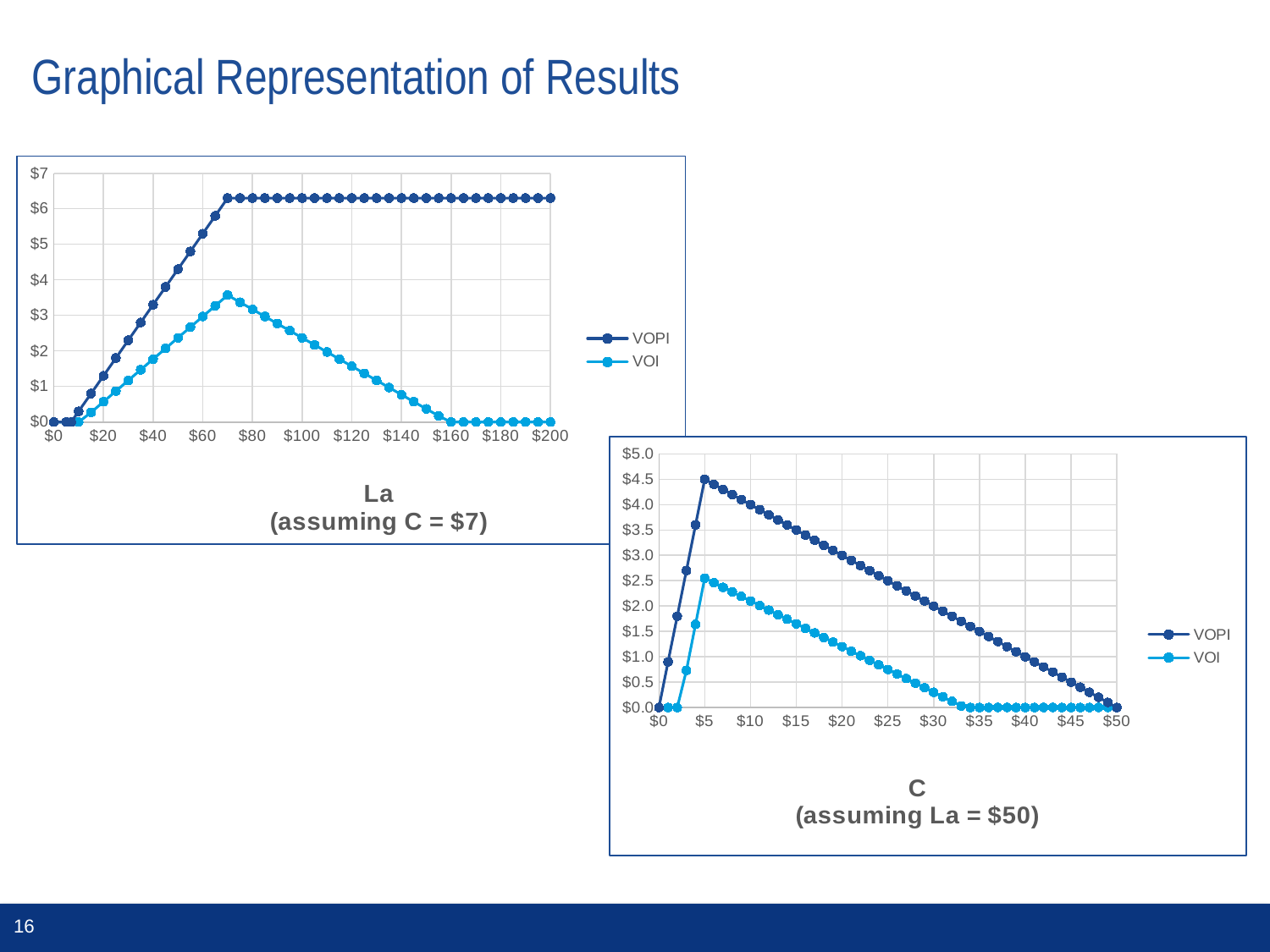
In the chart titled "C (assuming La = $50)", is the value of VOPI at $25 greater or less than $3.5? less What kind of chart is the chart titled "La (assuming C = $7)"? line chart In the chart titled "La (assuming C = $7)", which series has the larger value at $120, VOPI or VOI? VOPI How many series does the legend of the chart titled "C (assuming La = $50)" list? 2 In the chart titled "La (assuming C = $7)", does the VOI series rise or fall between $80 and $160? fall In the chart titled "La (assuming C = $7)", is the value of VOPI at $100 greater or less than $5? greater In the chart titled "La (assuming C = $7)", what is the value of VOI at $200? $0 In the chart titled "C (assuming La = $50)", what is the value of VOI at $40? $0.0 In the chart titled "C (assuming La = $50)", is the value of VOI at $20 greater or less than $2.0? less In the chart titled "C (assuming La = $50)", does the VOPI series rise or fall between $5 and $50? fall What are the two series named in the legend of the chart titled "La (assuming C = $7)"? VOPI and VOI